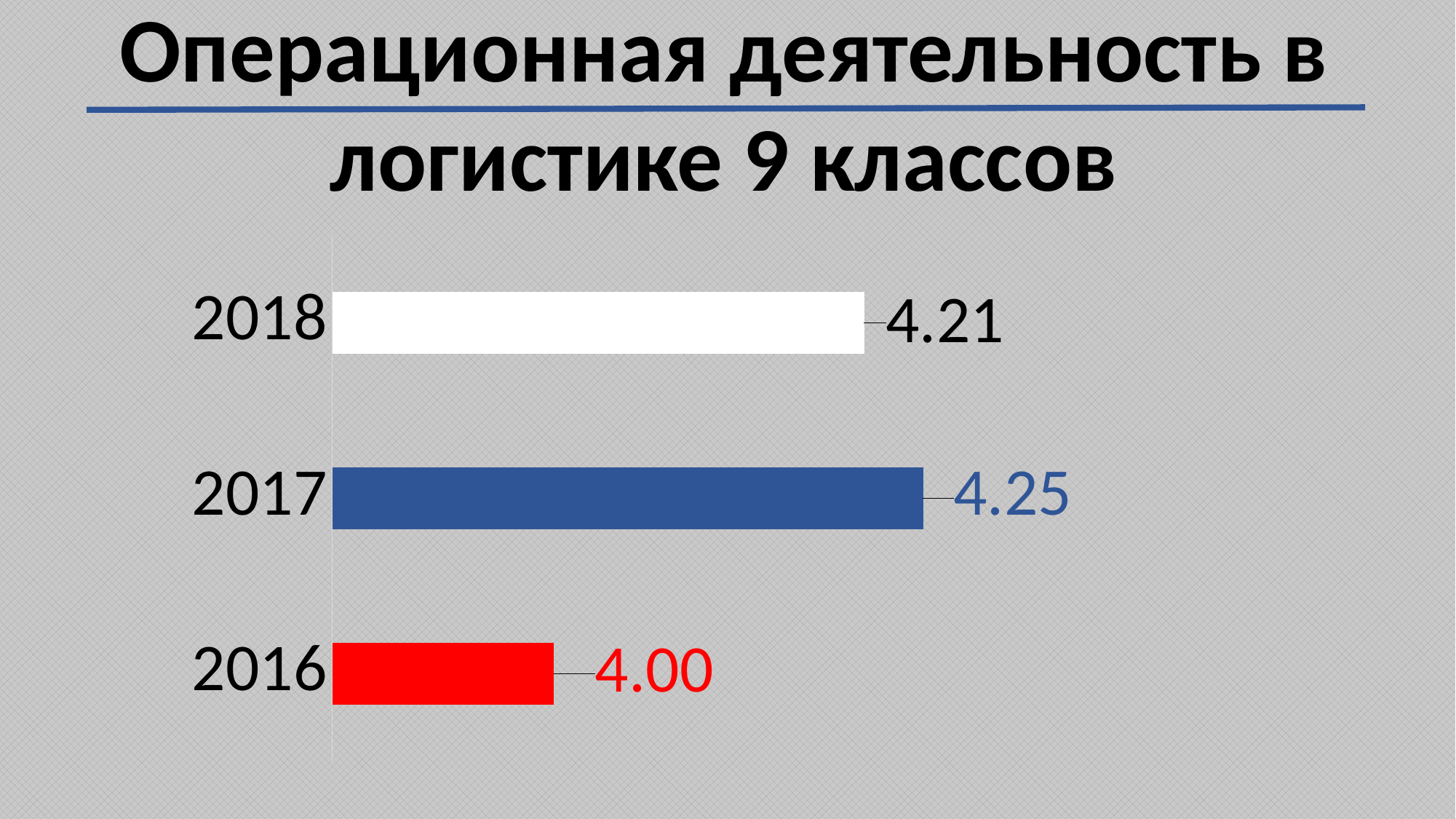
What is the value for 2017? 4.25 Which year has the highest value? 2017 What is the value for 2018? 4.21 What kind of chart is shown on the slide? bar chart Which is larger, the value for 2018 or the value for 2016? 2018 How many years are shown in the chart? 3 Which year has the lowest value? 2016 What colour is the bar for 2016? red What is the title of the slide? Операционная деятельность в логистике 9 классов What is the difference between the values for 2017 and 2018? 0.04 What is the difference between the values for 2017 and 2016? 0.25 What is the value for 2016? 4.00